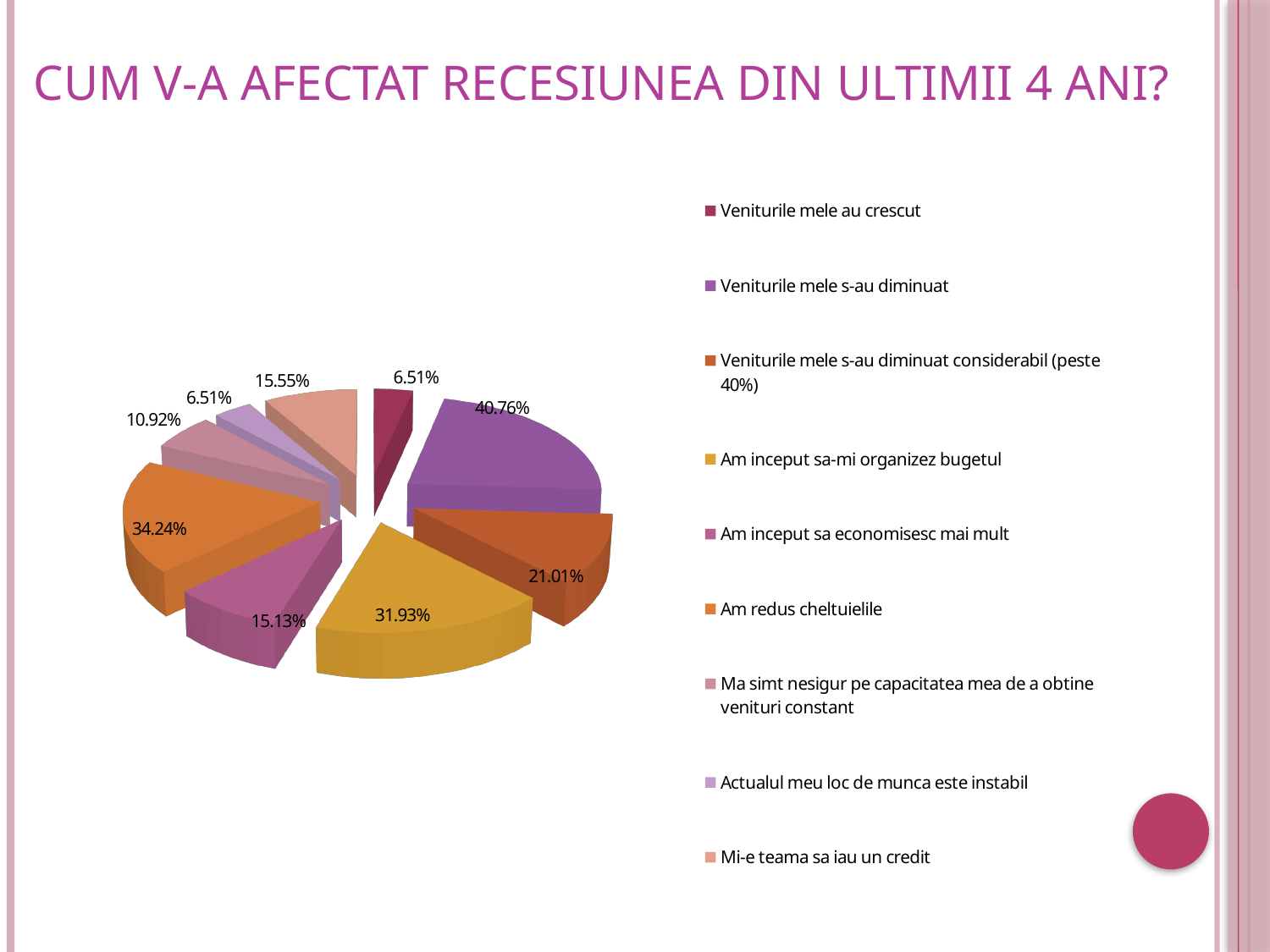
Which is larger: the slice for "Am inceput sa economisesc mai mult" or the slice for "Veniturile mele s-au diminuat considerabil (peste 40%)"? Veniturile mele s-au diminuat considerabil (peste 40%) What percentage is shown for "Am inceput sa-mi organizez bugetul"? 31.93% How many entries does the legend list? 9 What percentage is shown for "Am redus cheltuielile"? 34.24% What is the title of the slide containing the chart? CUM V-A AFECTAT RECESIUNEA DIN ULTIMII 4 ANI? What type of chart is shown on the slide? pie chart Which legend category has the largest slice in the pie chart? Veniturile mele s-au diminuat What percentage is shown for "Mi-e teama sa iau un credit"? 15.55% What percentage is shown for "Ma simt nesigur pe capacitatea mea de a obtine venituri constant"? 10.92% How many slices does the pie chart have? 9 What percentage is shown for "Veniturile mele s-au diminuat"? 40.76% What is the difference between the percentages for "Veniturile mele s-au diminuat" and "Am redus cheltuielile"? 6.52%